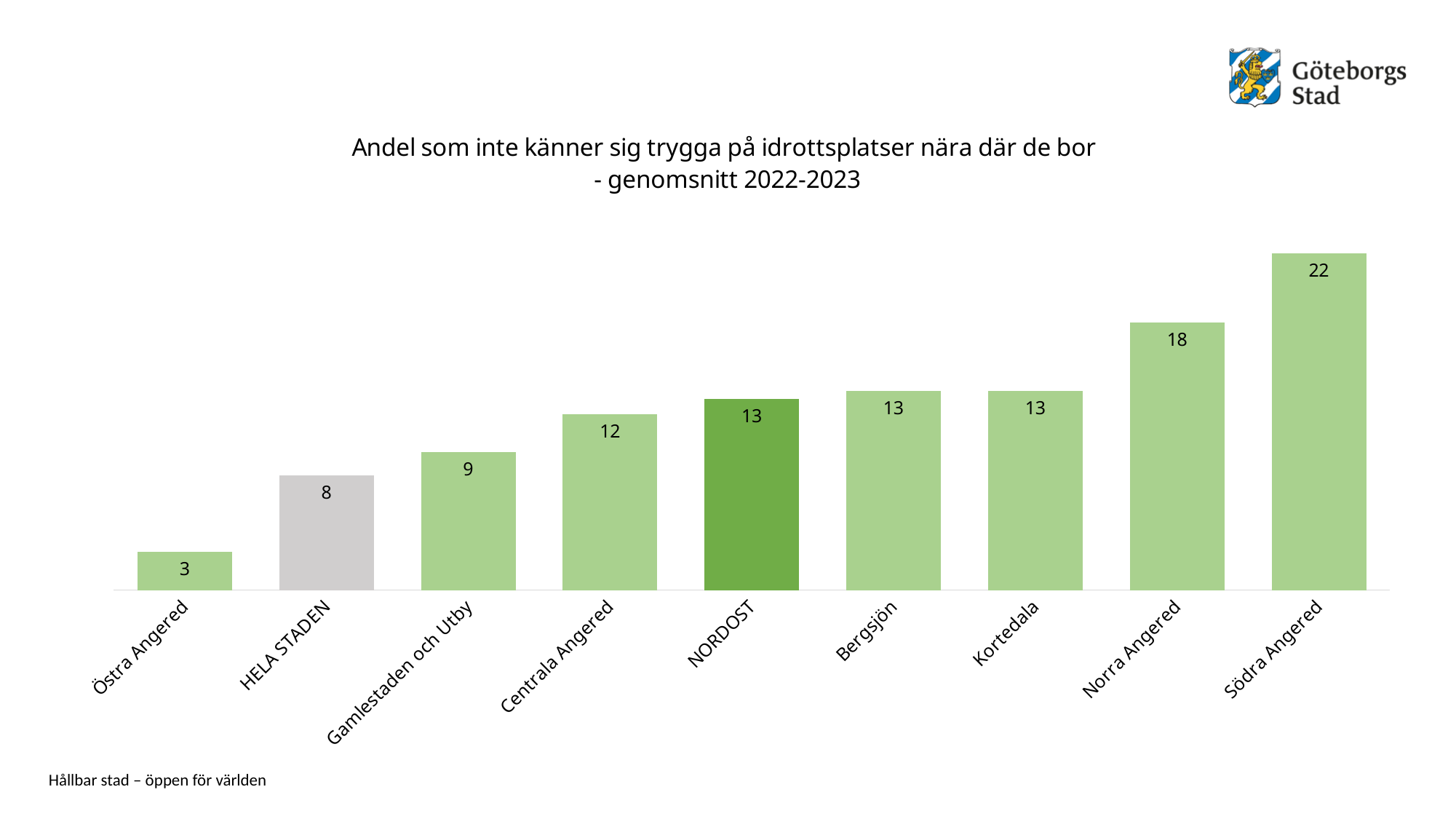
What is the value for NORDOST? 13 Which is larger, the value for Norra Angered or the value for Kortedala? Norra Angered What is the value for HELA STADEN? 8 What is the value for Gamlestaden och Utby? 9 What is the difference between the values for Södra Angered and Norra Angered? 4 What is the value for Södra Angered? 22 Which bar is shown in grey rather than green? HELA STADEN Which category has the highest value? Södra Angered What kind of chart is shown on the slide? Bar chart What is the difference between the values for Centrala Angered and Östra Angered? 9 How many categories are shown in the chart? 9 Which category has the lowest value? Östra Angered